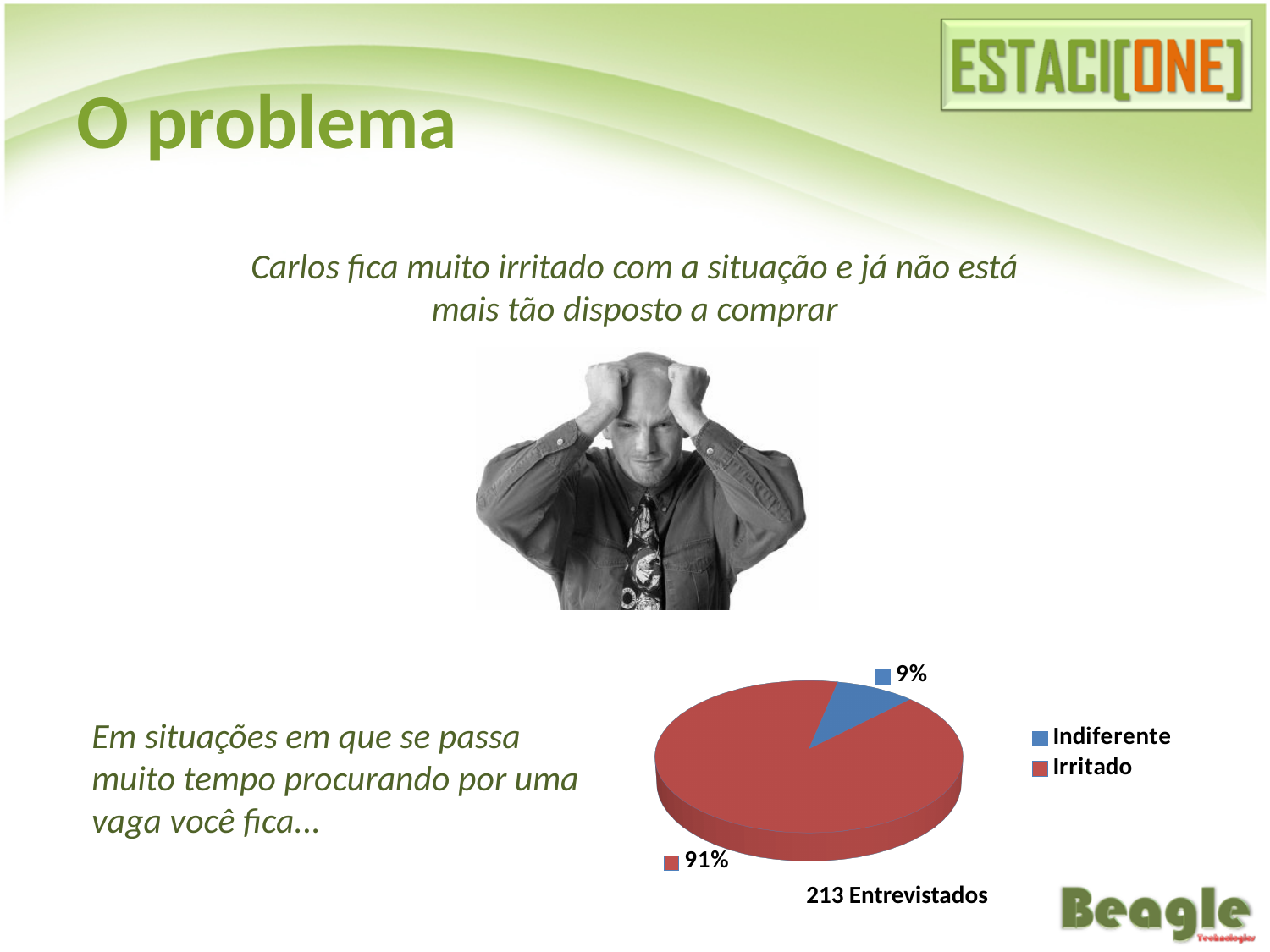
What kind of chart is shown on the slide? pie chart What is the difference in percentage points between the "Irritado" and "Indiferente" slices? 82 What percentage of respondents answered "Indiferente"? 9% Which is larger, the share for "Irritado" or the share for "Indiferente"? Irritado What colour is the "Indiferente" slice? blue How many people were interviewed according to the note below the chart? 213 How many slices does the pie chart have? 2 What share of the pie does the "Irritado" slice represent? 91% Which category has the largest share of the pie? Irritado Which category has the smallest share of the pie? Indiferente What percentage of respondents answered "Irritado"? 91% How many entries does the legend list? 2